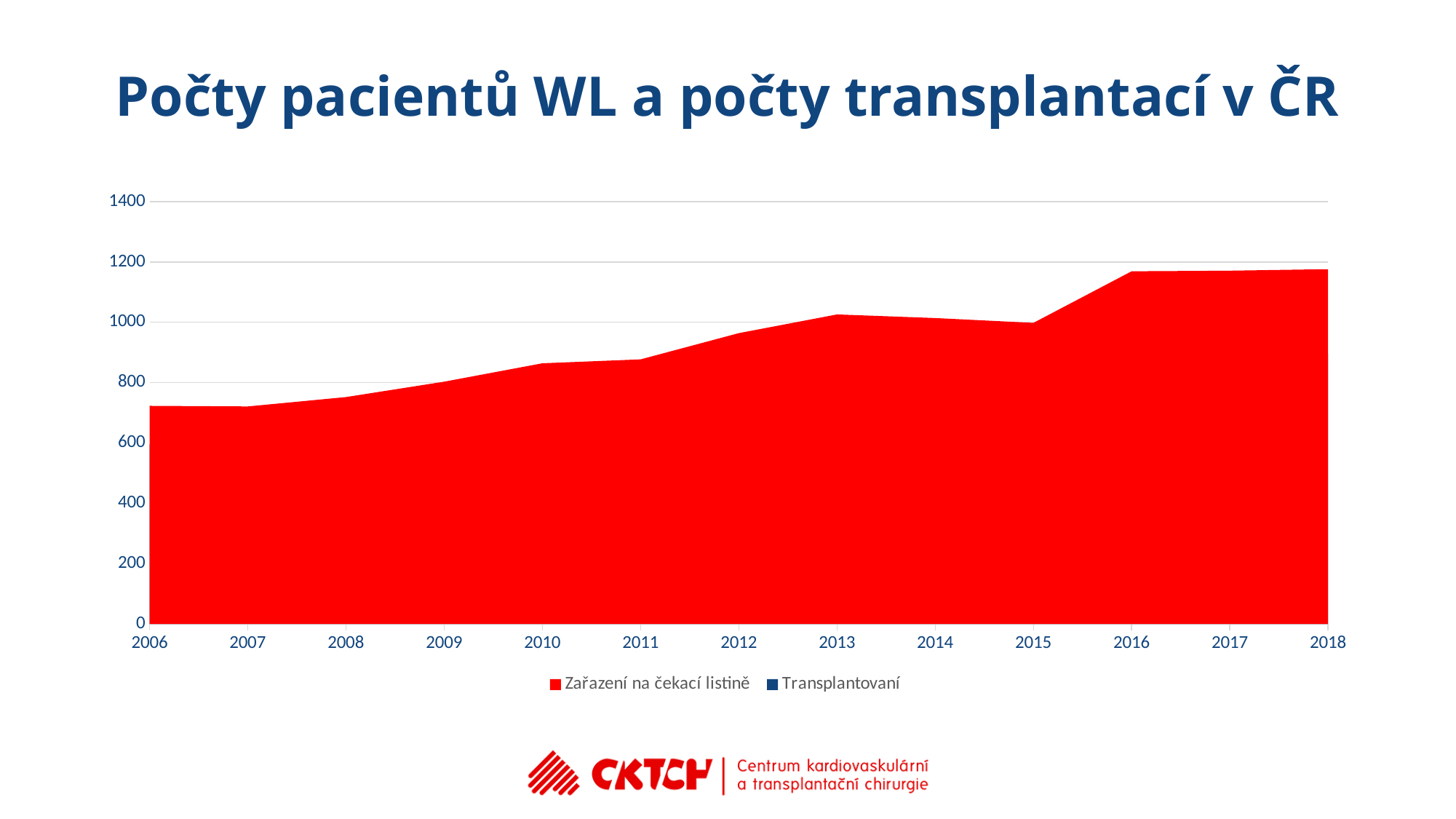
How many series does the legend list? 2 Is the value for Zařazení na čekací listině in 2018 greater or less than 1200? less Do the values for Zařazení na čekací listině generally rise or fall from 2006 to 2018? rise Is the value for Zařazení na čekací listině in 2016 greater or less than 1000? greater What is the title of the chart on the slide? Počty pacientů WL a počty transplantací v ČR Which year has the larger value for Zařazení na čekací listině, 2006 or 2018? 2018 What kind of chart is shown on the slide? area chart Is the value for Zařazení na čekací listině in 2013 greater or less than 800? greater How many years are plotted along the x axis? 13 Which year has the larger value for Zařazení na čekací listině, 2010 or 2012? 2012